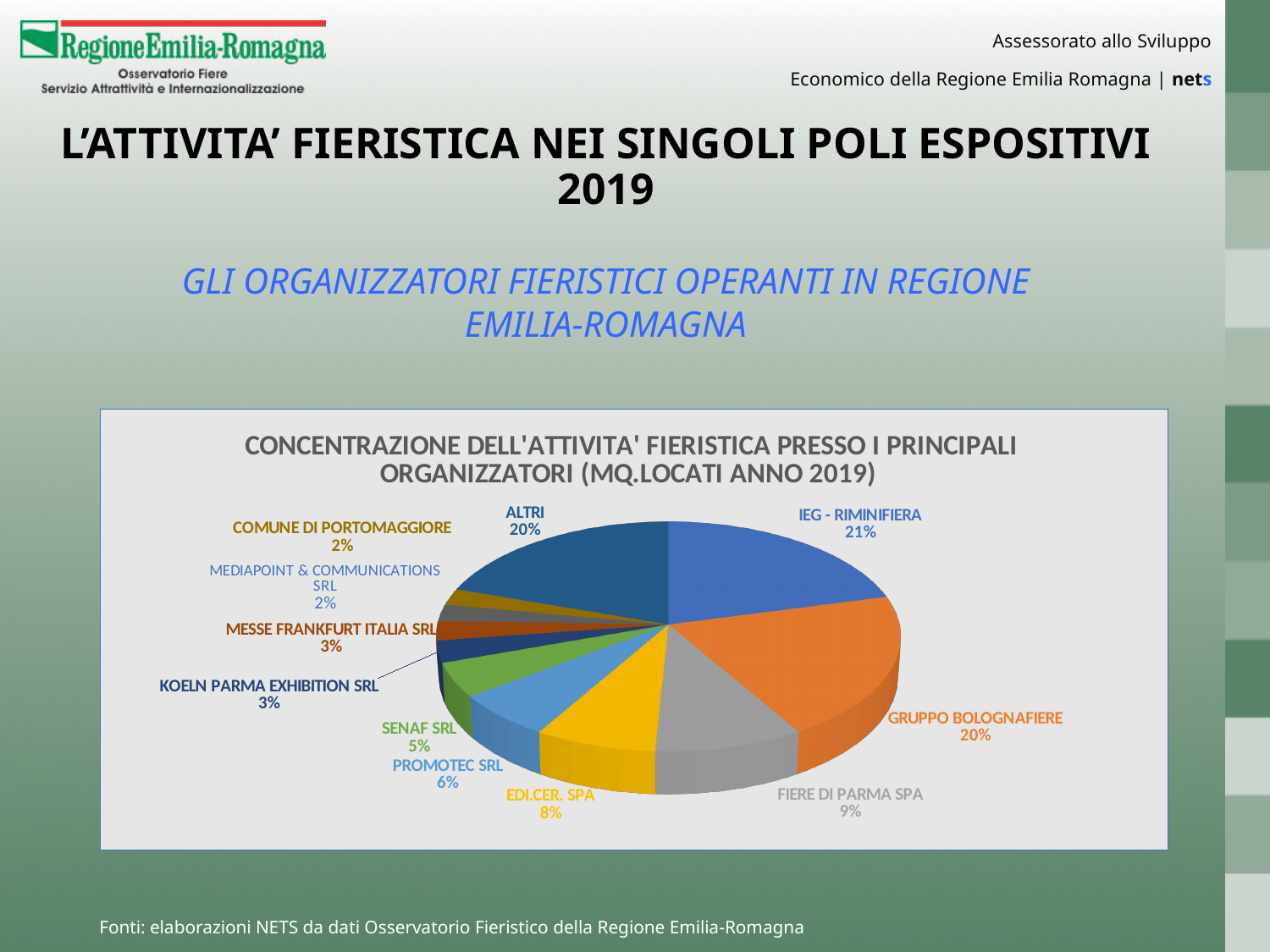
What is the value shown for GRUPPO BOLOGNAFIERE? 20% What is the value shown for SENAF SRL? 5% What is the title of the chart? CONCENTRAZIONE DELL'ATTIVITA' FIERISTICA PRESSO I PRINCIPALI ORGANIZZATORI (MQ.LOCATI ANNO 2019) What is the value shown for PROMOTEC SRL? 6% What is the difference in percentage points between IEG - RIMINIFIERA and FIERE DI PARMA SPA? 12 percentage points Which organizer has the largest slice of the pie? IEG - RIMINIFIERA What kind of chart is shown on the slide? pie chart Which is larger, the share of EDI.CER. SPA or the share of PROMOTEC SRL? EDI.CER. SPA How many slices does the pie chart have? 11 What is the value shown for FIERE DI PARMA SPA? 9% What is the value shown for the ALTRI slice? 20% What share of the pie does IEG - RIMINIFIERA hold? 21%